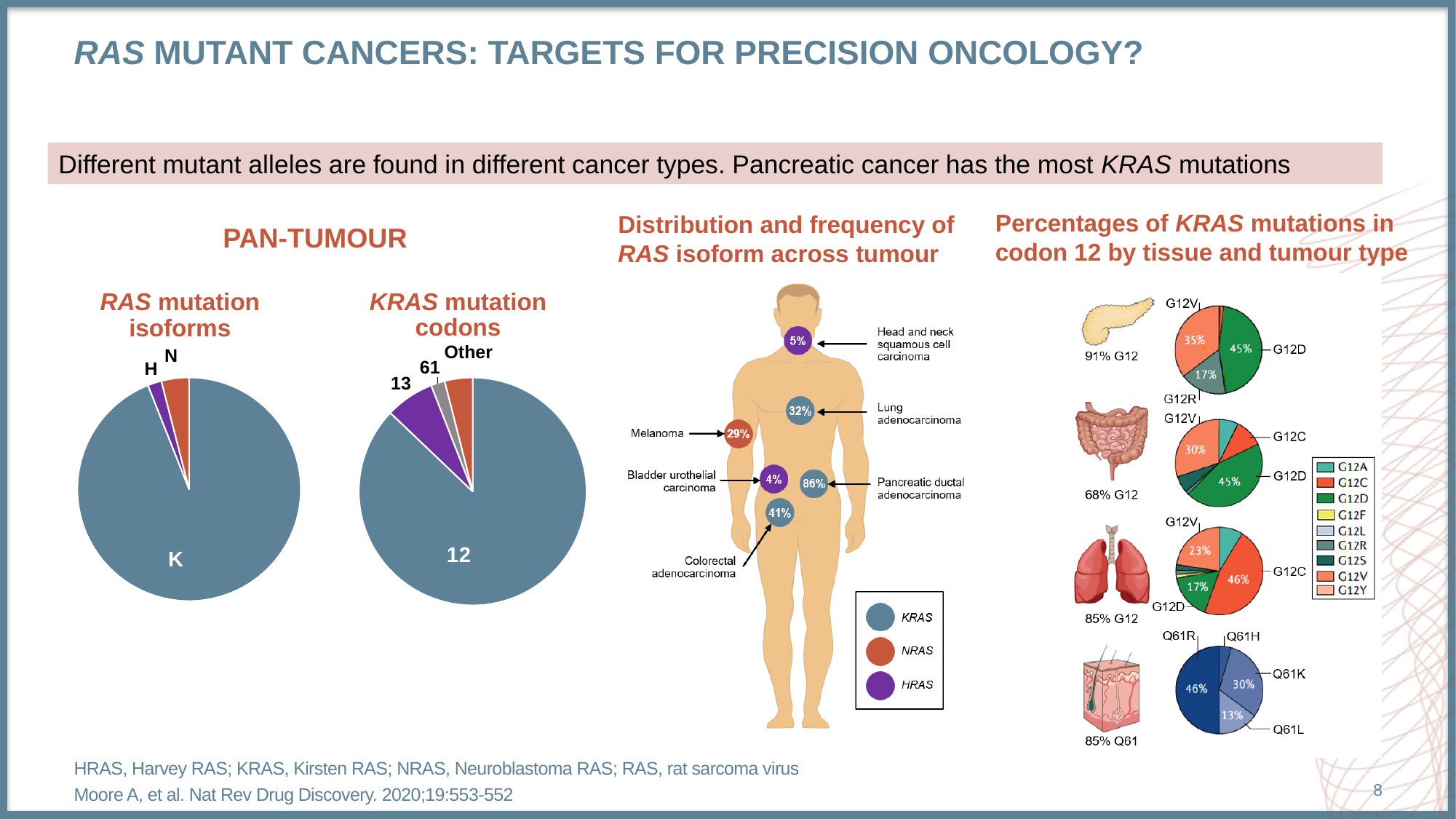
In the 'Percentages of KRAS mutations in codon 12' panel, what percentage of the lung pie chart is G12C? 46% In the 'RAS mutation isoforms' pie chart, which isoform has the largest slice? K How many slices does the 'KRAS mutation codons' pie chart have? 4 How many entries does the legend of the body diagram 'Distribution and frequency of RAS isoform across tumour' list? 3 In the 'Percentages of KRAS mutations in codon 12' panel, what percentage of the pancreas pie chart is G12D? 45% In the body diagram 'Distribution and frequency of RAS isoform across tumour', what is the difference between the percentages for pancreatic ductal adenocarcinoma and lung adenocarcinoma? 54% What kind of chart is used for 'KRAS mutation codons'? Pie chart In the 'Percentages of KRAS mutations in codon 12' panel, what percentage of the skin pie chart is Q61K? 30% In the body diagram 'Distribution and frequency of RAS isoform across tumour', which has the larger percentage, lung adenocarcinoma or melanoma? Lung adenocarcinoma In the body diagram 'Distribution and frequency of RAS isoform across tumour', what percentage is shown for pancreatic ductal adenocarcinoma? 86% How many entries does the legend in the 'Percentages of KRAS mutations in codon 12' panel list? 9 In the body diagram 'Distribution and frequency of RAS isoform across tumour', which tumour type has the lowest percentage shown? Bladder urothelial carcinoma